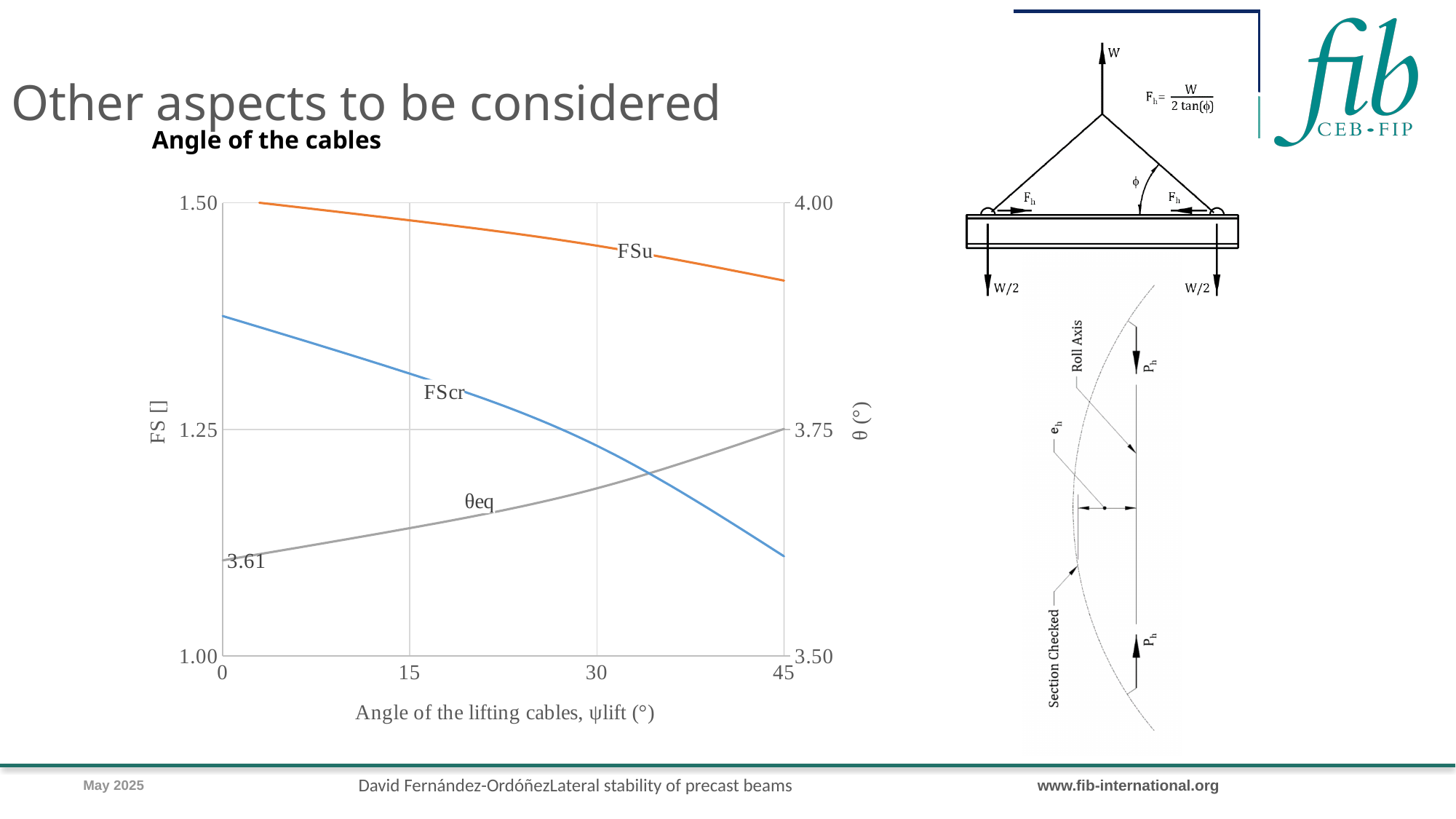
Is the value of FSu at 45° greater or less than 1.25? greater Does θeq rise or fall as the angle of the lifting cables increases? rise Does FSu rise or fall as the angle of the lifting cables increases? fall Does FScr rise or fall as the angle of the lifting cables increases? fall Is the value of θeq at 30° greater or less than 3.75? less How many data series are plotted on the chart? 3 What kind of chart is shown on the slide? line chart Which is larger at an angle of 0°, FSu or FScr? FSu What is the title of the horizontal axis of the chart? Angle of the lifting cables, ψlift (°) What is the value of θeq at an angle of 0°, as labelled on the chart? 3.61 Is the value of FScr at 45° greater or less than 1.25? less What is the title of the chart? Angle of the cables